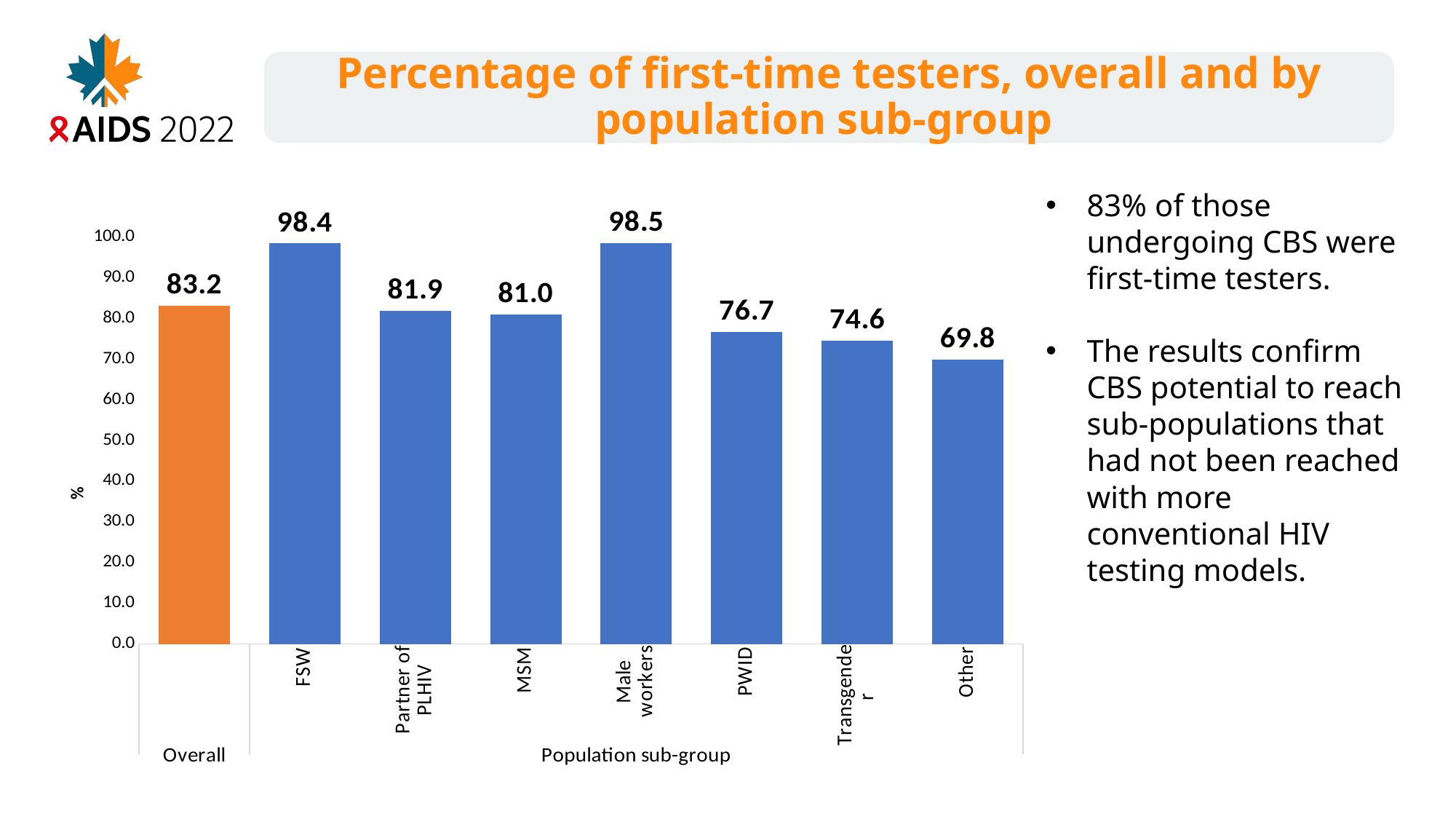
What kind of chart is shown on the slide? bar chart How many bars are plotted in the chart? 8 Which is larger, the value for FSW or the value for MSM? FSW Which category has the lowest percentage of first-time testers? Other What is the percentage of first-time testers for the Overall category? 83.2 What is the value shown for PWID? 76.7 What is the value shown for Male workers? 98.5 What is the value shown for Transgender? 74.6 What is the difference between the FSW value and the PWID value? 21.7 What is the difference between the Overall value and the Other value? 13.4 Which bar is coloured orange rather than blue? Overall Is the value for PWID greater or less than 80.0? less